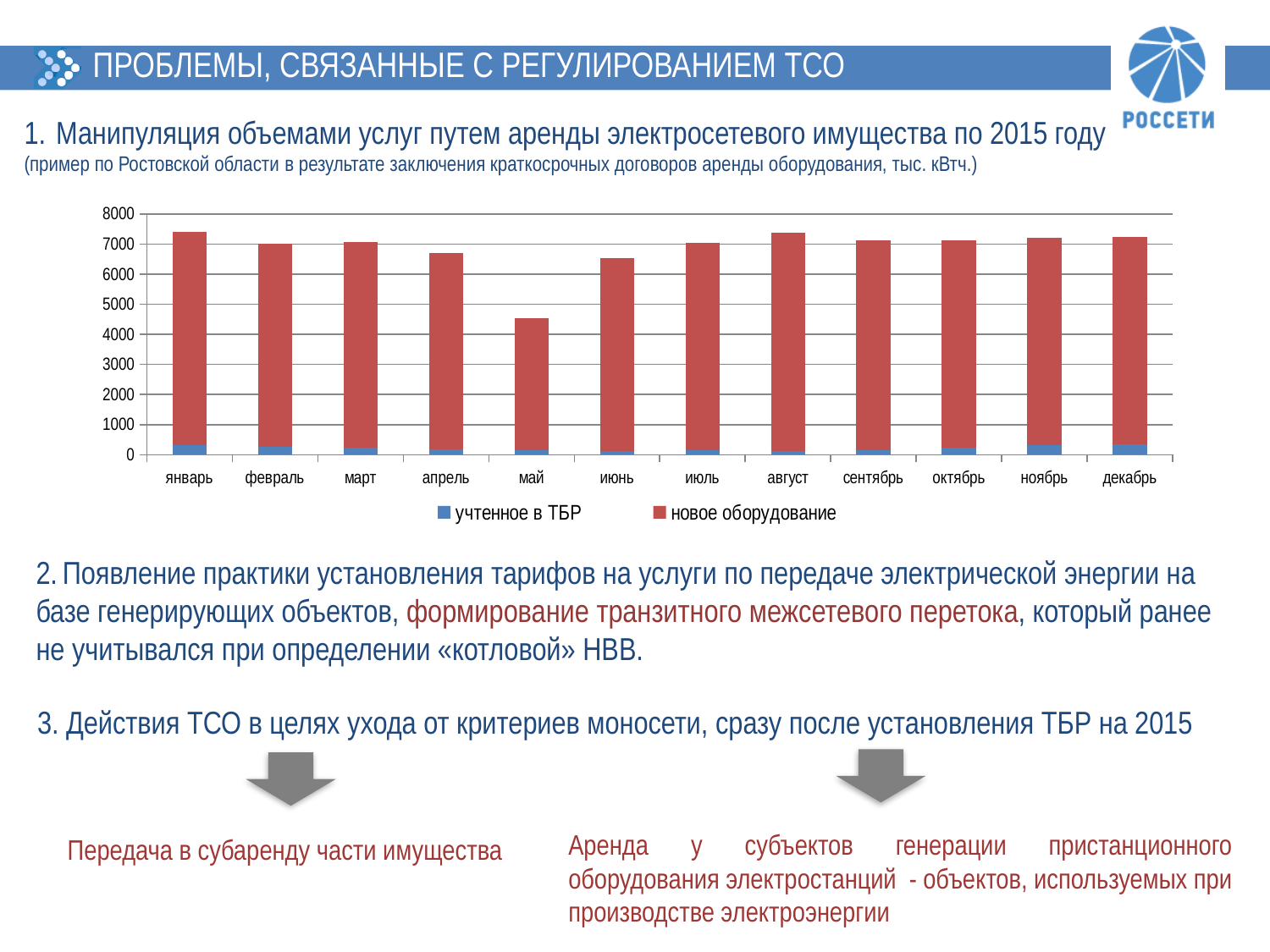
What kind of chart is shown on the slide? stacked bar chart Which series is shown in red in the chart? новое оборудование How many months (categories) are shown on the x axis of the chart? 12 Is the total value for апрель greater or less than 7000? less Is the total value for май greater or less than 5000? less Which month has the larger total bar, апрель or январь? январь Is the total value for январь greater or less than 7000? greater How many series does the chart legend list? 2 Which series is shown in blue in the chart? учтенное в ТБР Which month has the lowest total bar in the chart? май Which month has the larger total bar, май or июнь? июнь